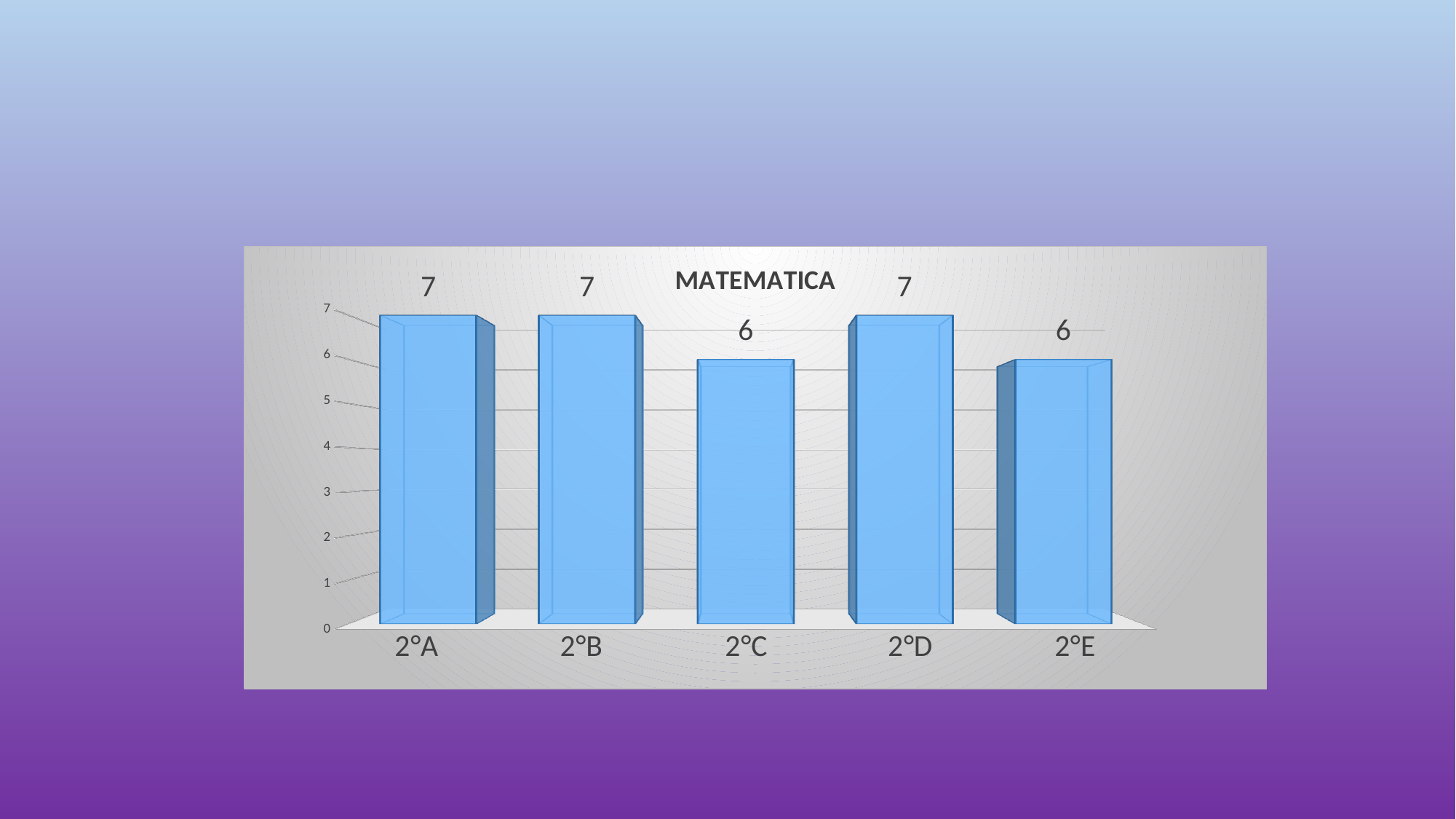
What kind of chart is shown on the slide? Bar chart What is the title of the chart? MATEMATICA How many categories are shown on the chart? 5 Is the value for 2°B larger than the value for 2°E? Yes What is the value for 2°E? 6 What is the value for 2°D? 7 What is the difference between the values for 2°A and 2°C? 1 Is the value for 2°D greater or less than 5? greater What is the value for 2°C? 6 What is the value for 2°A? 7 Which category has the lowest value, 2°B or 2°C? 2°C What is the total of the values for 2°C and 2°E? 12